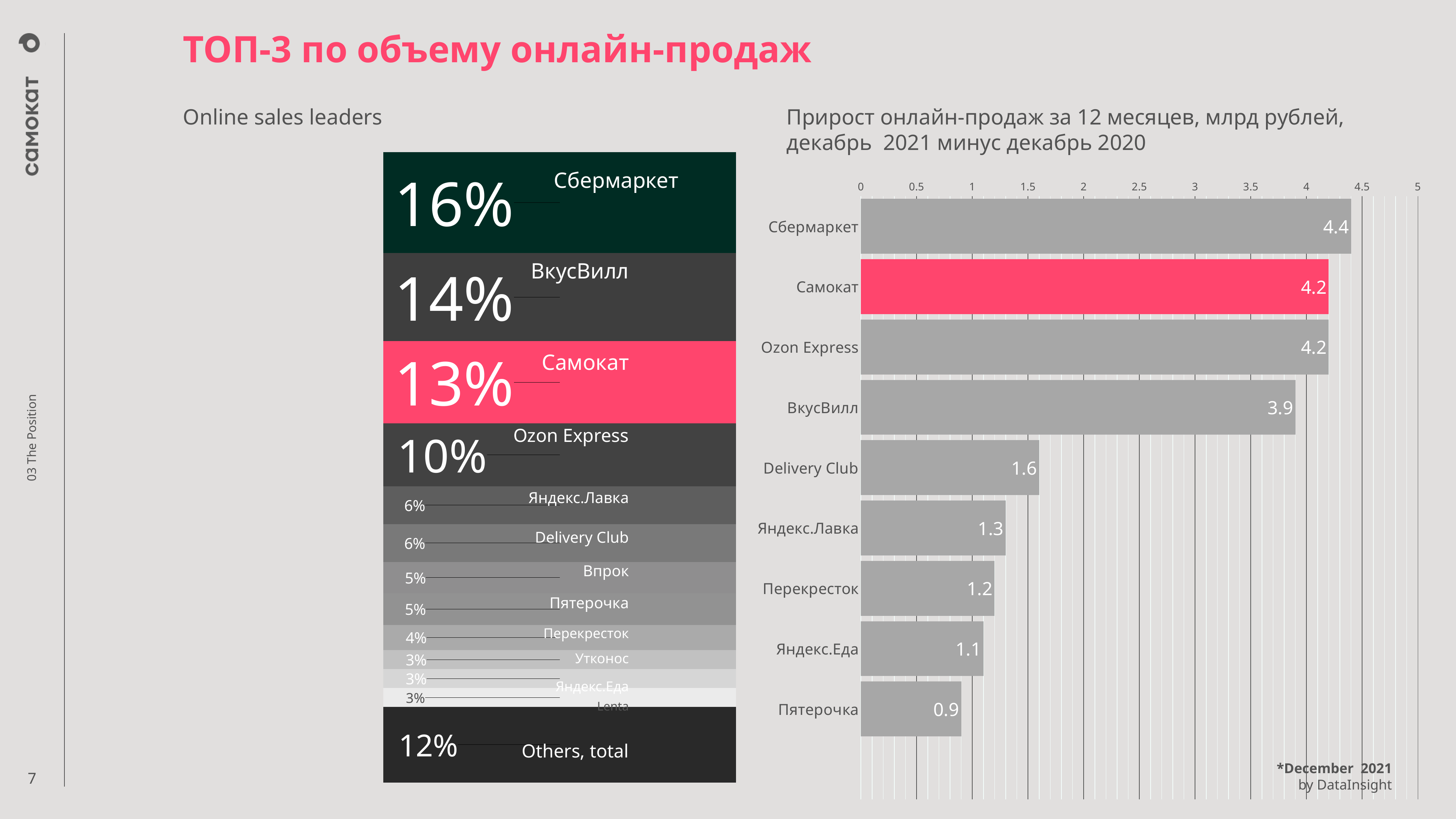
In the right chart (Прирост онлайн-продаж за 12 месяцев), what is the value for Delivery Club? 1.6 In the left chart (Online sales leaders), which company has the largest share? Сбермаркет In the right chart (Прирост онлайн-продаж за 12 месяцев), which is larger: the value for Яндекс.Лавка or the value for Перекресток? Яндекс.Лавка What kind of chart is the right chart (Прирост онлайн-продаж за 12 месяцев)? Bar chart In the right chart (Прирост онлайн-продаж за 12 месяцев), what is the difference between the values for Сбермаркет and ВкусВилл? 0.5 In the left chart (Online sales leaders), what share is shown for Others, total? 12% In the left chart (Online sales leaders), what share is shown for Самокат? 13% In the right chart (Прирост онлайн-продаж за 12 месяцев), which company has the lowest value? Пятерочка In the right chart (Прирост онлайн-продаж за 12 месяцев), which company has the highest value? Сбермаркет In the right chart (Прирост онлайн-продаж за 12 месяцев), which bar is highlighted in pink? Самокат In the right chart (Прирост онлайн-продаж за 12 месяцев), what is the value for Сбермаркет? 4.4 In the right chart (Прирост онлайн-продаж за 12 месяцев), how many companies are shown? 9